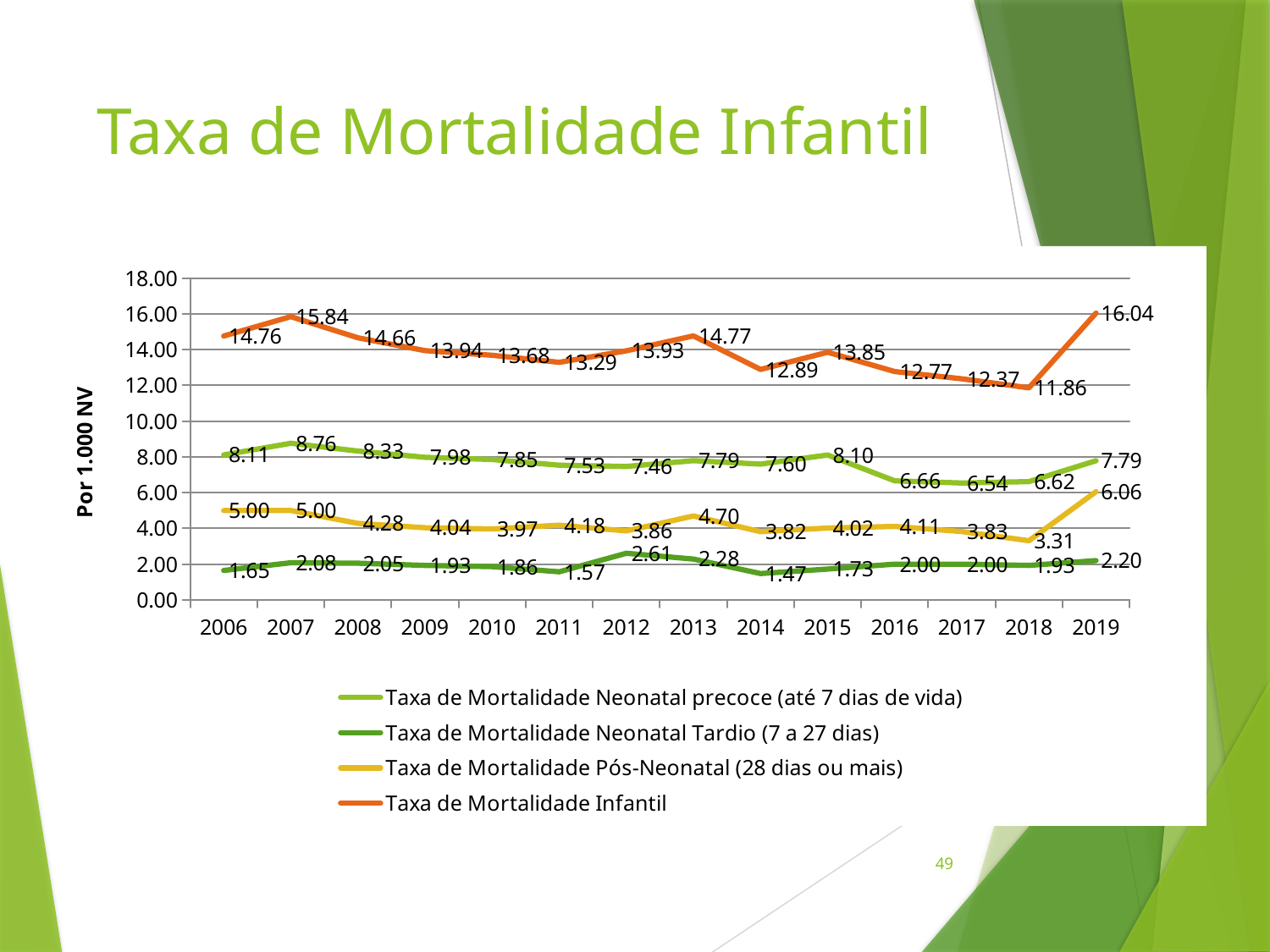
In which year is Taxa de Mortalidade Infantil lowest? 2018 What is the value of Taxa de Mortalidade Neonatal Tardio (7 a 27 dias) in 2012? 2.61 What is the value of Taxa de Mortalidade Neonatal precoce (até 7 dias de vida) in 2007? 8.76 How many series does the legend list? 4 What is the value of Taxa de Mortalidade Pós-Neonatal (28 dias ou mais) in 2018? 3.31 What is the label of the vertical axis? Por 1.000 NV What is the value of Taxa de Mortalidade Infantil in 2019? 16.04 How many years are plotted along the x axis? 14 In which year is Taxa de Mortalidade Neonatal Tardio (7 a 27 dias) lowest? 2014 What type of chart is shown on the slide? Line chart Which is larger: Taxa de Mortalidade Neonatal precoce in 2006 or in 2016? 2006 What is the difference between the Taxa de Mortalidade Infantil values for 2019 and 2018? 4.18